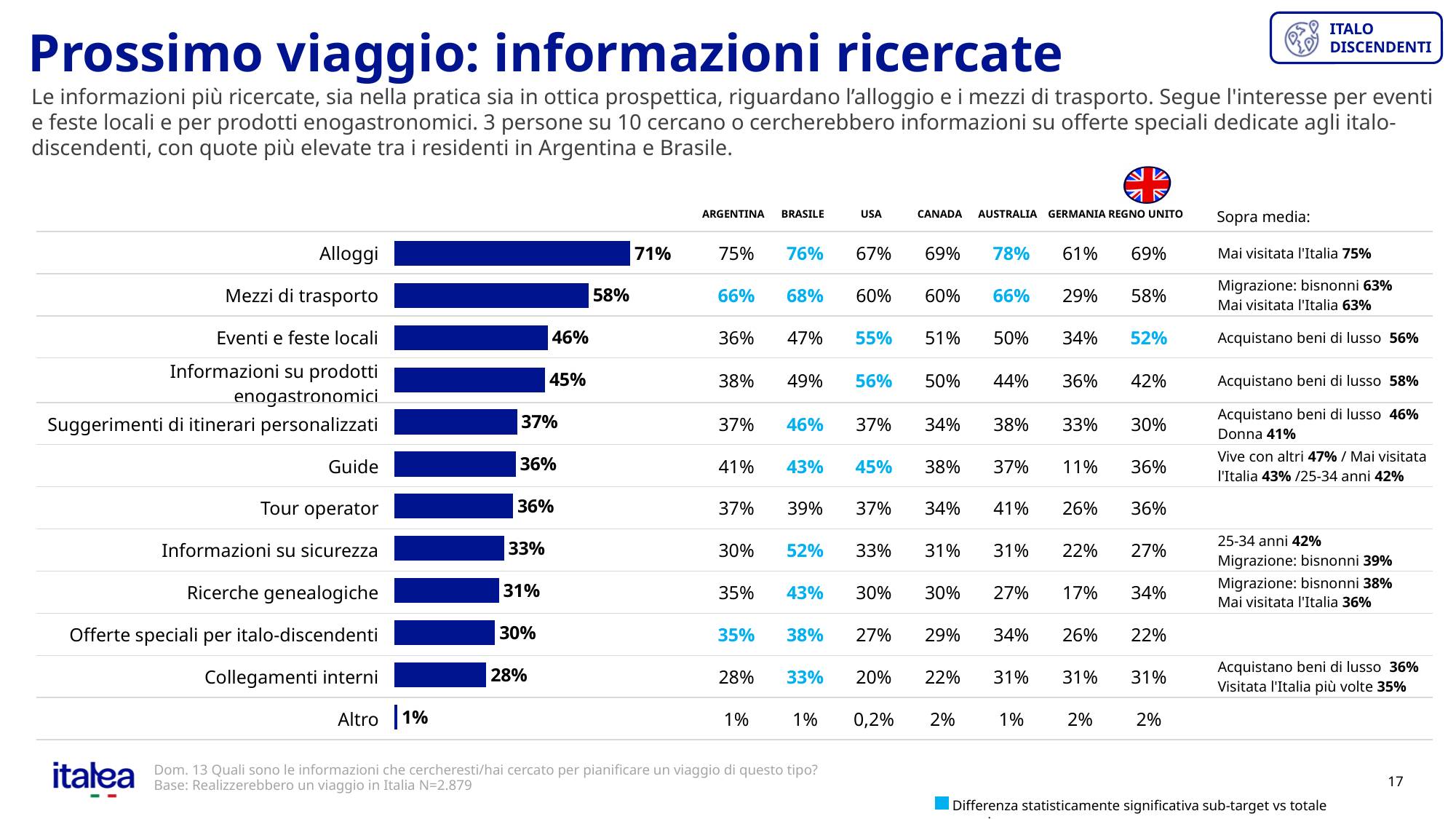
Which has a larger value in the bar chart, Ricerche genealogiche or Informazioni su sicurezza? Informazioni su sicurezza Which category has the lowest value in the bar chart? Altro What is the difference between the values for Eventi e feste locali and Informazioni su sicurezza in the bar chart? 13% What is the value shown for Mezzi di trasporto in the bar chart? 58% What is the value shown for Alloggi in the bar chart? 71% What is the difference between the values for Alloggi and Mezzi di trasporto in the bar chart? 13% How many categories are shown in the bar chart? 12 What is the value shown for Offerte speciali per italo-discendenti in the bar chart? 30% What kind of chart is shown on the slide? Bar chart What is the title of the slide containing the chart? Prossimo viaggio: informazioni ricercate Which category has the highest value in the bar chart? Alloggi What is the value shown for Collegamenti interni in the bar chart? 28%